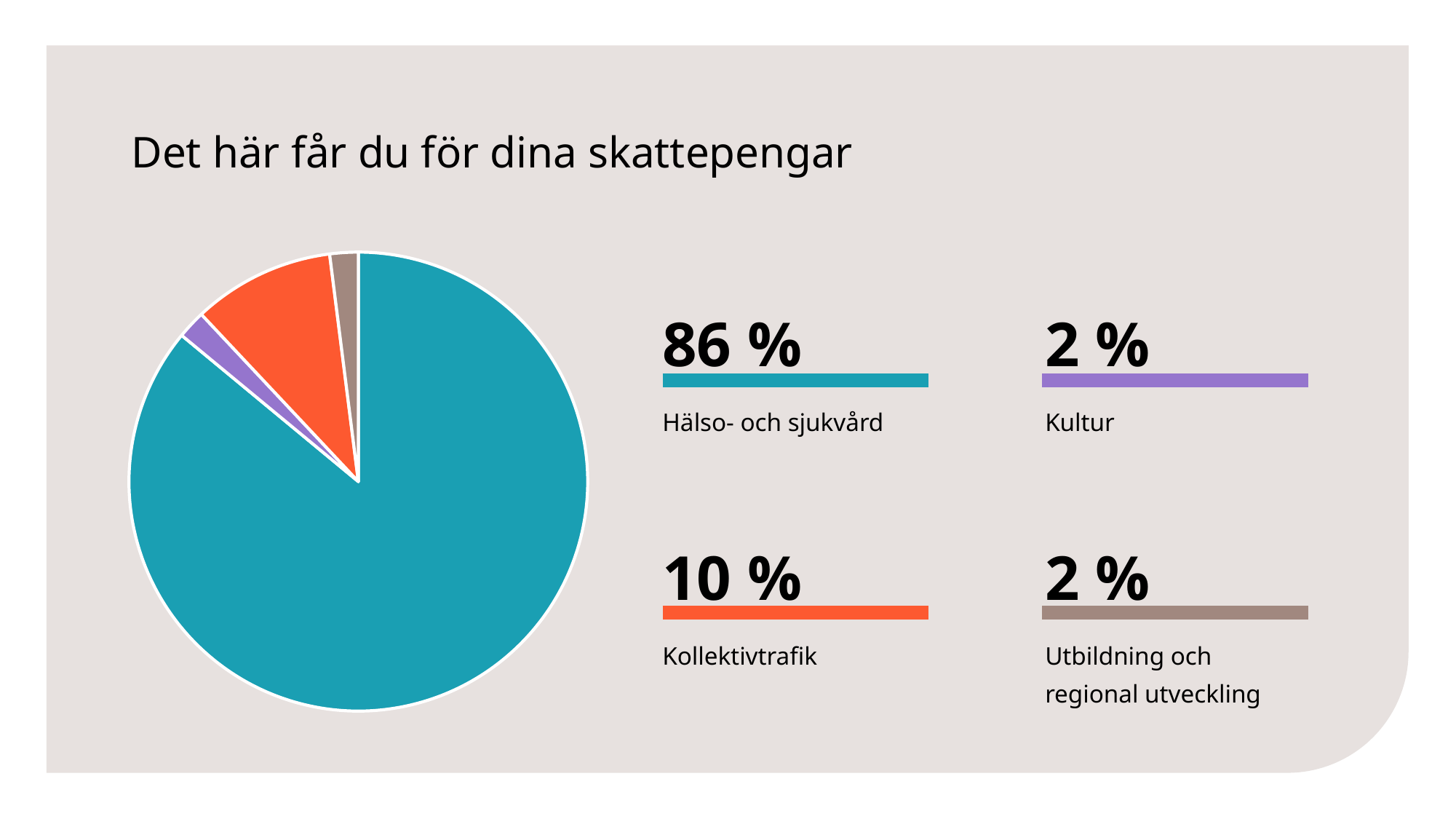
What share of the pie does Kollektivtrafik represent? 10 % What share of the pie does Utbildning och regional utveckling represent? 2 % What share of the pie does Hälso- och sjukvård represent? 86 % What is the title of the slide containing the pie chart? Det här får du för dina skattepengar What colour is the slice for Kollektivtrafik? orange Which category has the largest slice of the pie? Hälso- och sjukvård What is the difference between the shares for Hälso- och sjukvård and Kollektivtrafik? 76 % How many categories are shown in the pie chart? 4 Which is larger, the share for Kollektivtrafik or the share for Kultur? Kollektivtrafik What is the difference between the shares for Kollektivtrafik and Utbildning och regional utveckling? 8 % What kind of chart is shown on the slide? pie chart